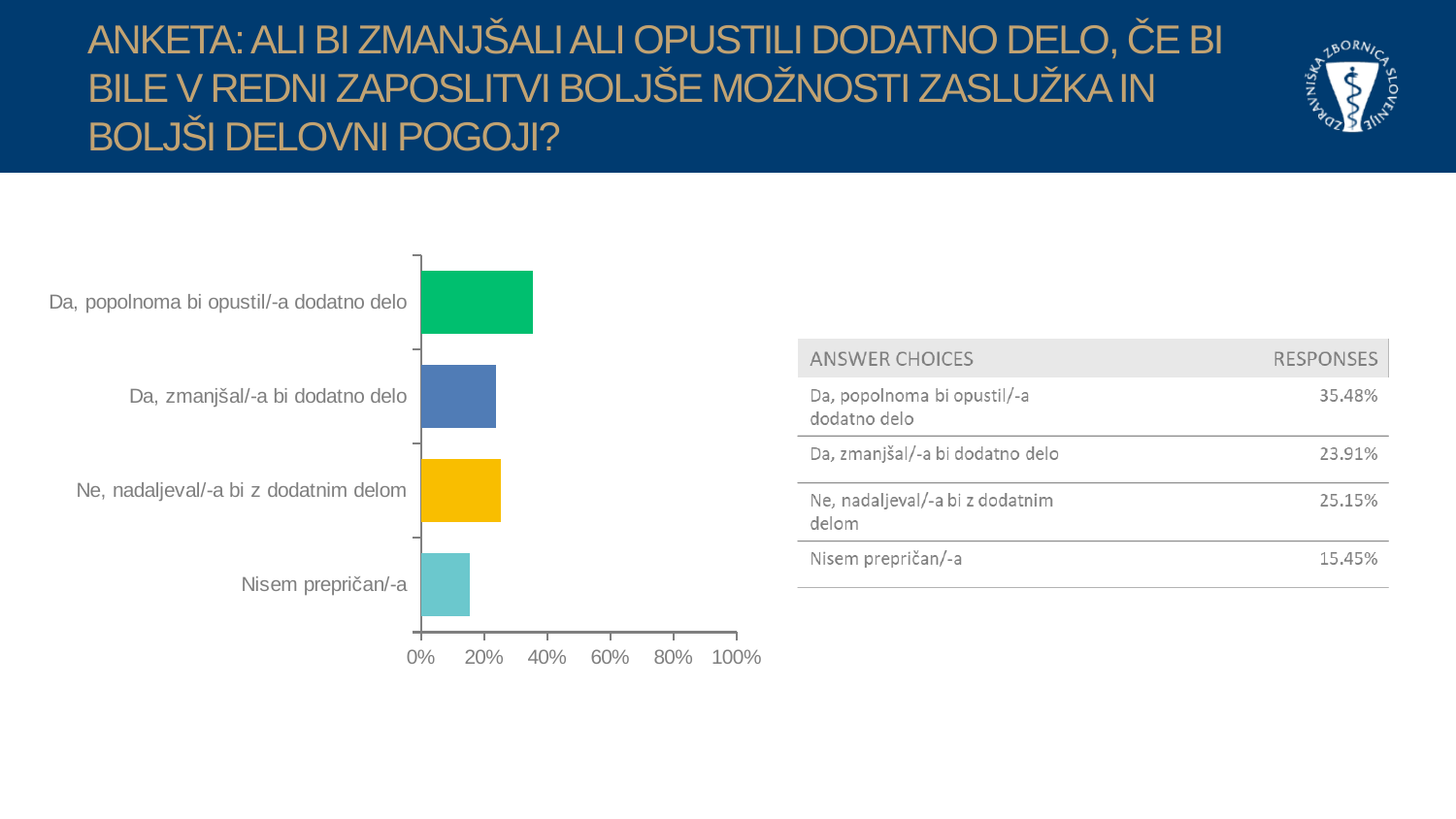
What is the difference between the response shares for "Da, popolnoma bi opustil/-a dodatno delo" and "Nisem prepričan/-a"? 20.03% According to the table, what is the response share for "Nisem prepričan/-a"? 15.45% Is the bar for "Da, popolnoma bi opustil/-a dodatno delo" greater or less than 40%? less Which is larger: the response share for "Ne, nadaljeval/-a bi z dodatnim delom" or for "Da, zmanjšal/-a bi dodatno delo"? Ne, nadaljeval/-a bi z dodatnim delom According to the table, what is the response share for "Ne, nadaljeval/-a bi z dodatnim delom"? 25.15% According to the table, what is the response share for "Da, popolnoma bi opustil/-a dodatno delo"? 35.48% Which answer choice has the lowest response share? Nisem prepričan/-a Which answer choice has the highest response share? Da, popolnoma bi opustil/-a dodatno delo According to the table, what is the response share for "Da, zmanjšal/-a bi dodatno delo"? 23.91% What kind of chart is shown on the slide? bar chart How many categories does the bar chart show? 4 What is the maximum value shown on the x axis of the bar chart? 100%